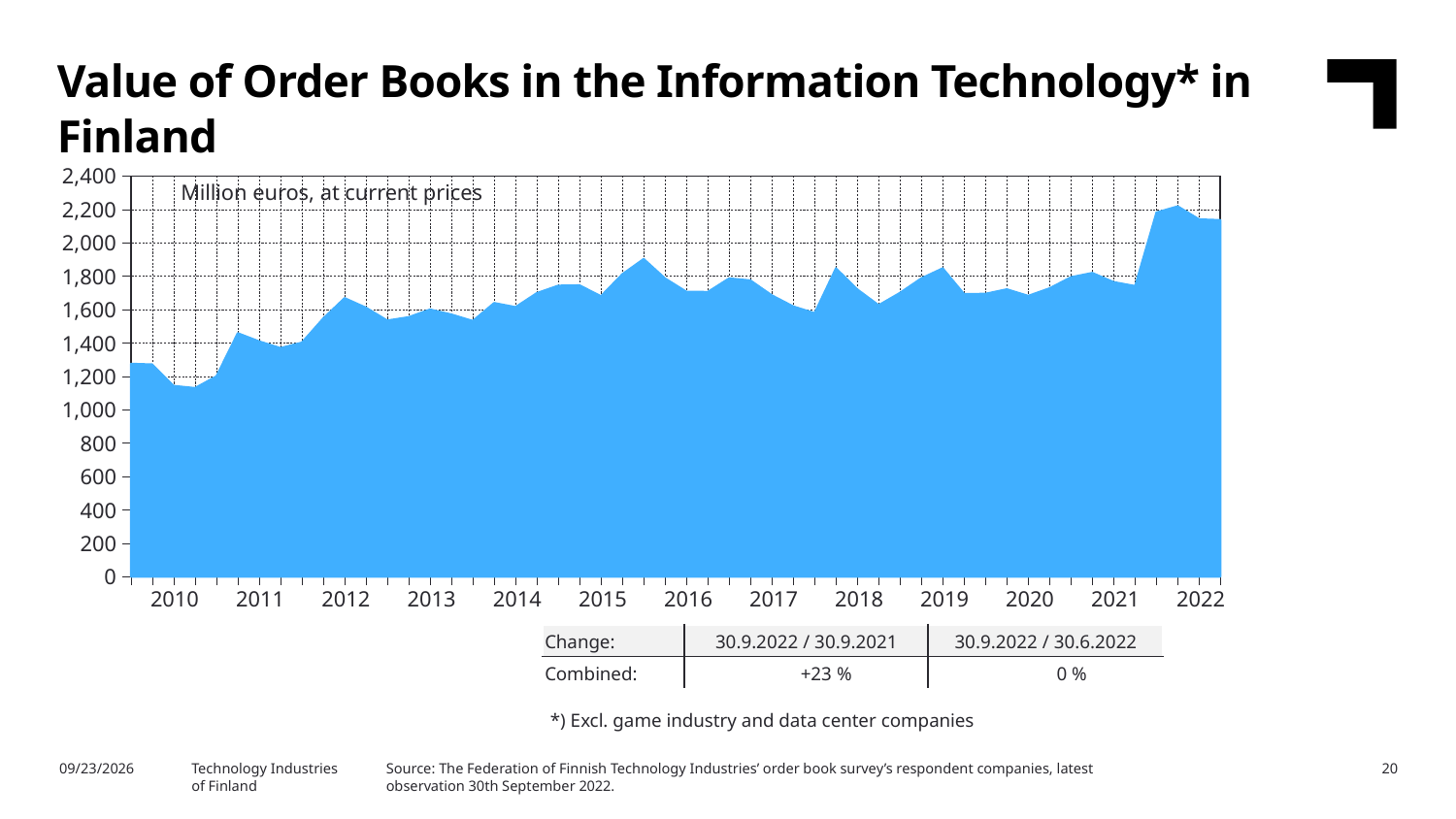
Is the value of order books at the start of 2010 greater or less than 1,400? less Is the dip in 2018 greater or less than 1,800? less Overall, do the values rise or fall from 2010 to 2022? rise What is the title of the chart? Value of Order Books in the Information Technology* in Finland In which year does the value of order books reach its highest level? 2022 In which year is the value of order books at its lowest? 2010 Is the highest value reached in 2022 greater or less than 2,000? greater In what unit are the values on the chart expressed? Million euros, at current prices What kind of chart is shown on the slide? Area chart What is the combined change for 30.9.2022 / 30.9.2021 shown below the chart? +23 %